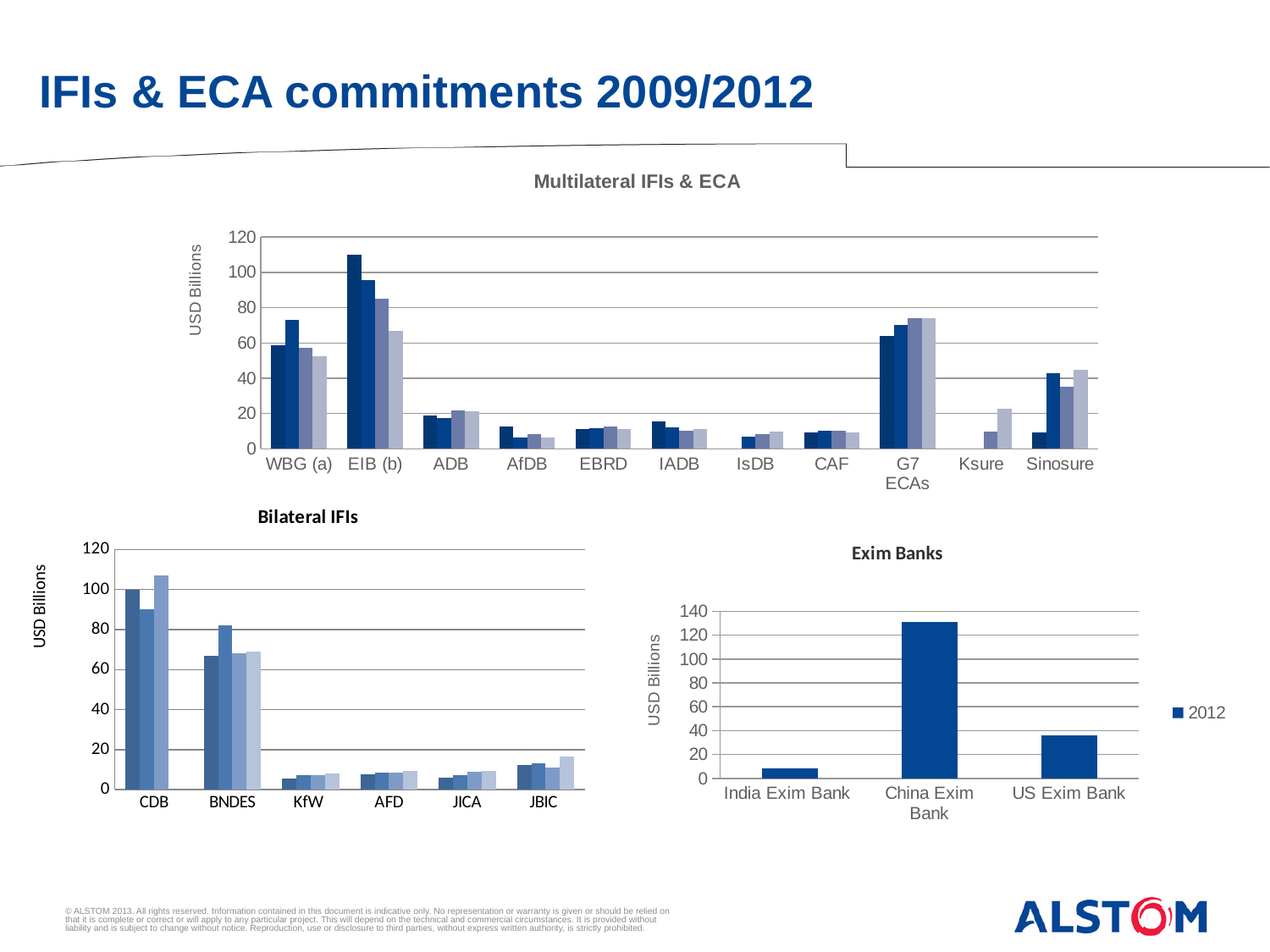
How many categories are shown on the x axis of the 'Bilateral IFIs' chart? 6 In the 'Exim Banks' chart, which bank has the highest value? China Exim Bank How many categories are shown on the x axis of the 'Multilateral IFIs & ECA' chart? 11 What year does the legend of the 'Exim Banks' chart show? 2012 What kind of chart is the 'Exim Banks' chart? bar chart In the 'Exim Banks' chart, which bank has the lowest value? India Exim Bank In the 'Bilateral IFIs' chart, which institution has the tallest bar? CDB How many series does the legend of the 'Exim Banks' chart list? 1 In the 'Exim Banks' chart, is the value for China Exim Bank greater or less than 120? greater In the 'Bilateral IFIs' chart, are the bars for JBIC greater or less than 40? less In the 'Exim Banks' chart, is the value for US Exim Bank greater or less than 60? less In the 'Multilateral IFIs & ECA' chart, which category has the tallest bar? EIB (b)